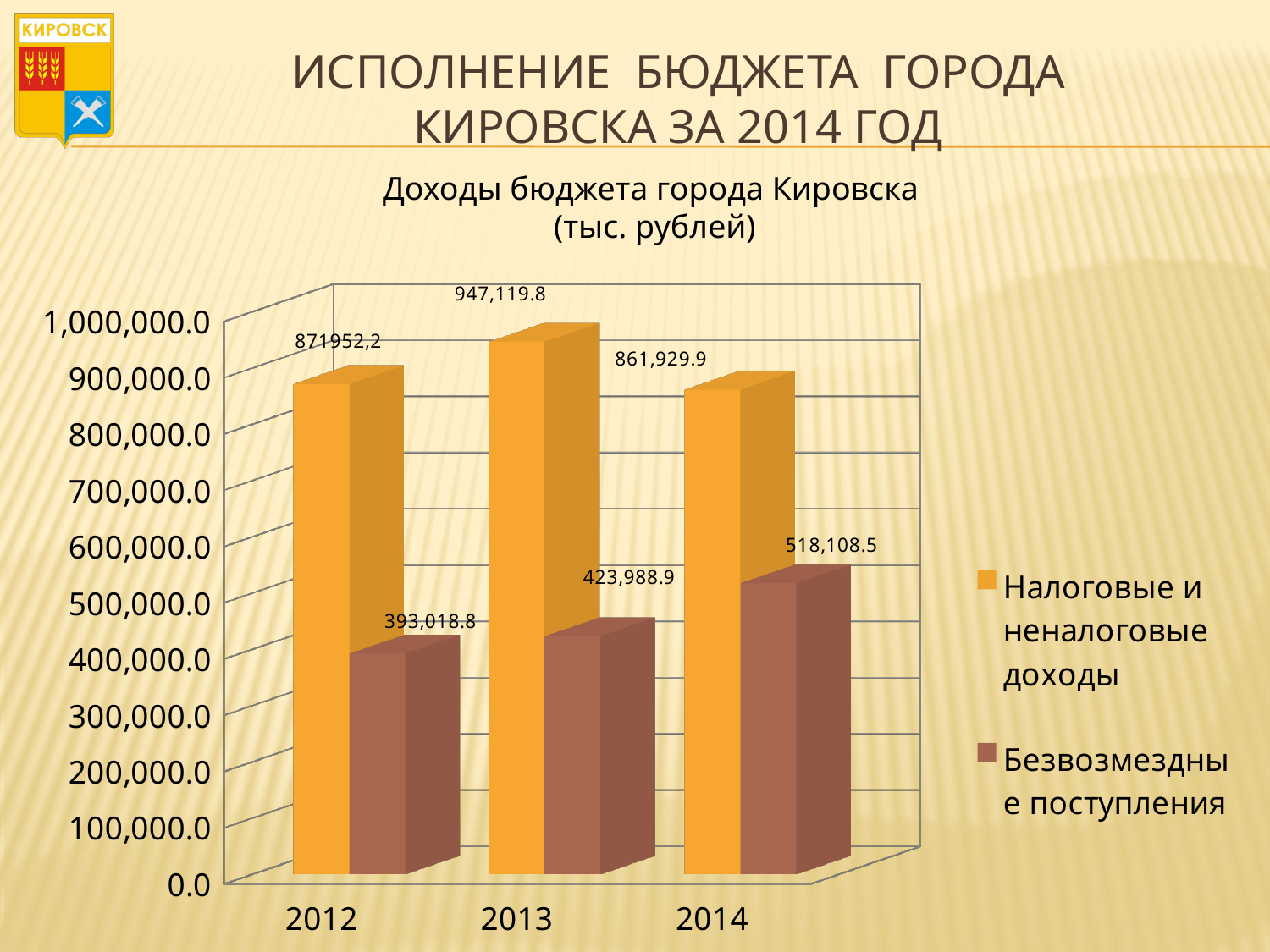
In which year is Безвозмездные поступления lowest? 2012 How many series does the legend list? 2 What is the value of Безвозмездные поступления for 2012? 393,018.8 What is the value of Безвозмездные поступления for 2014? 518,108.5 In which year is Налоговые и неналоговые доходы highest? 2013 How many years are shown on the x axis? 3 What kind of chart is shown on the slide? Bar chart What is the difference between Налоговые и неналоговые доходы in 2013 and in 2014? 85,189.9 What is the difference between Безвозмездные поступления in 2014 and in 2012? 125,089.7 Which is larger: Безвозмездные поступления in 2013 or in 2014? 2014 What is the value of Налоговые и неналоговые доходы for 2014? 861,929.9 What is the value of Налоговые и неналоговые доходы for 2013? 947,119.8